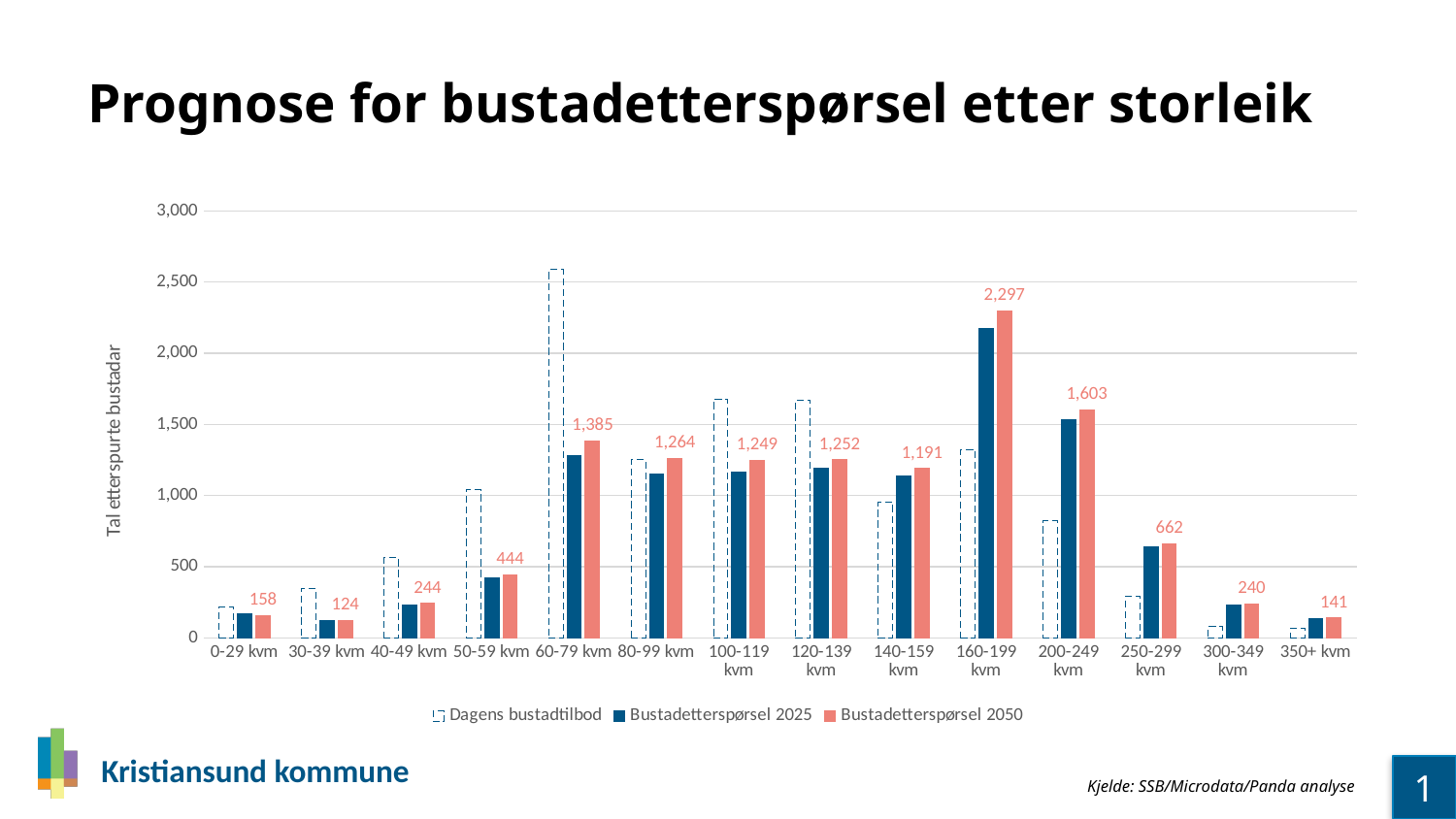
What is the Bustadetterspørsel 2050 value for 250-299 kvm? 662 What type of chart is shown on the slide? Bar chart What is the Bustadetterspørsel 2050 value for 60-79 kvm? 1,385 How many series does the legend list? 3 What is the difference between the Bustadetterspørsel 2050 values for 160-199 kvm and 200-249 kvm? 694 How many size categories are shown on the x axis? 14 Which size category has the highest Bustadetterspørsel 2050 value? 160-199 kvm Is the Dagens bustadtilbod value for 200-249 kvm greater or less than 1,000? less What is the Bustadetterspørsel 2050 value for 160-199 kvm? 2,297 Which is larger for Bustadetterspørsel 2050: 80-99 kvm or 140-159 kvm? 80-99 kvm Is the Dagens bustadtilbod value for 60-79 kvm greater or less than 2,500? greater Which size category has the lowest Bustadetterspørsel 2050 value? 30-39 kvm